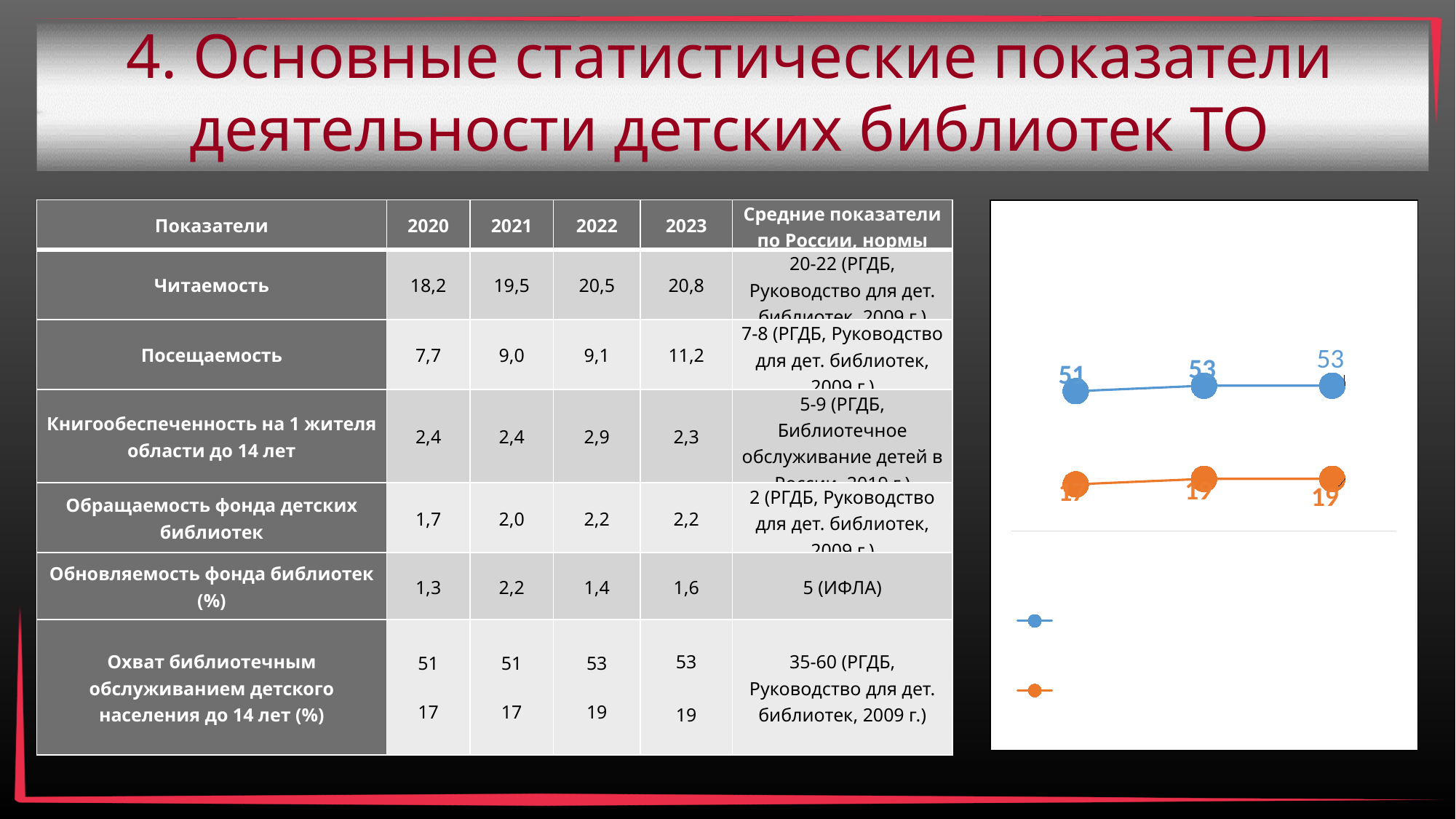
How many data points does the blue line in the chart on the right have? 3 What kind of chart is shown on the right side of the slide? line chart In the chart on the right, what is the value of the last point on the orange line? 19 In the chart on the right, does the blue line rise or fall from its first point to its last point? rise In the chart on the right, what is the value of the first point on the blue line? 51 In the chart on the right, what is the difference between the last point of the blue line (53) and the last point of the orange line (19)? 34 How many series does the legend of the chart on the right list? 2 In the chart on the right, what is the highest value labelled on the blue line? 53 In the chart on the right, which line has the higher value at the last point, the blue or the orange? blue In the chart on the right, by how much does the blue line increase from its first point (51) to its last point (53)? 2 In the chart on the right, what is the value of the last point on the blue line? 53 What two colours are used for the lines in the chart on the right? blue and orange